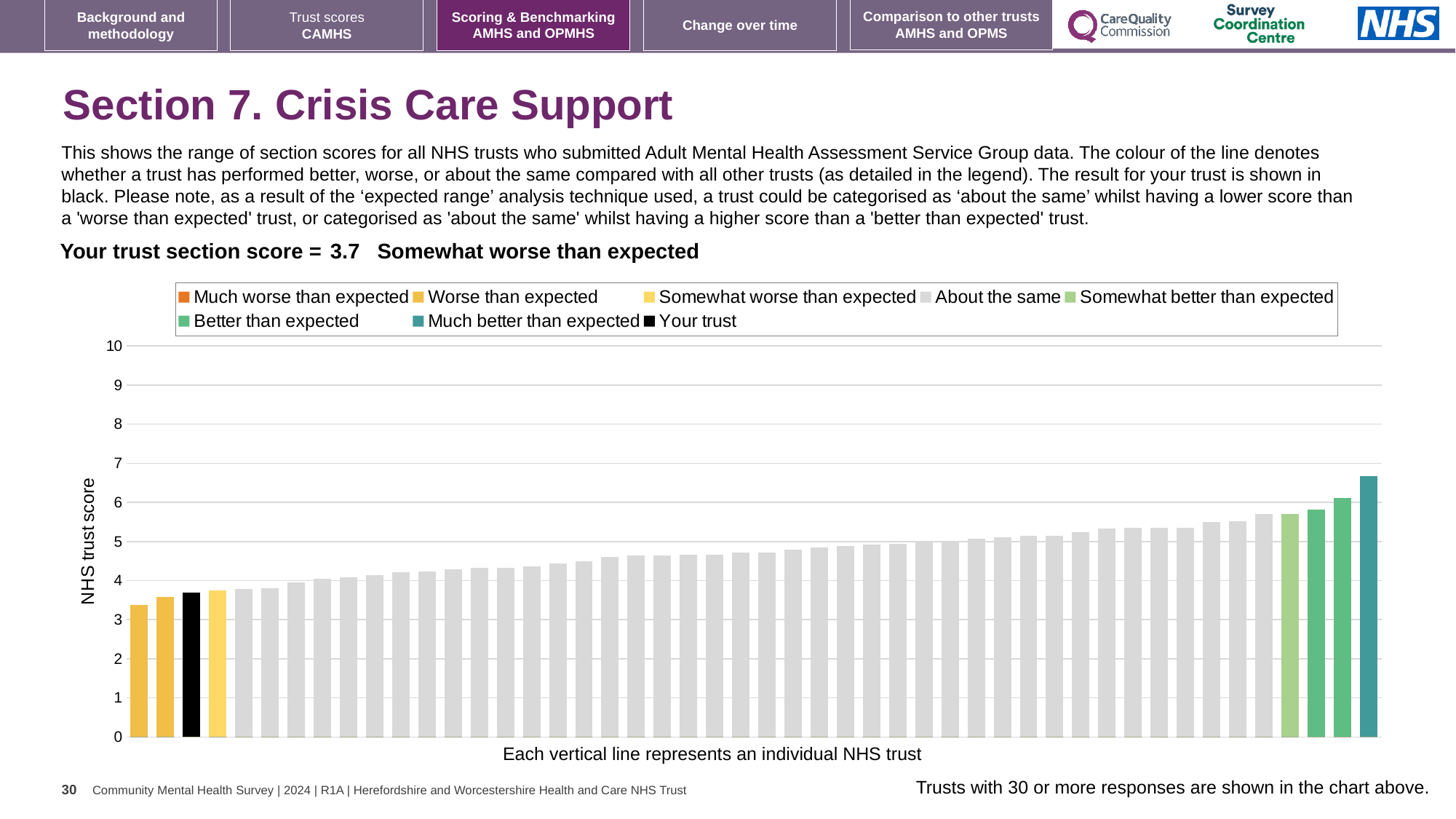
Is the value of the tallest bar greater or less than 6? greater Is the value of the tallest bar greater or less than 7? less Do the bar values rise or fall from left to right along the x axis? rise What kind of chart is shown on the slide? bar chart How many bars are coloured as 'Much better than expected'? 1 Which legend category does the shortest bar belong to? Worse than expected How many entries does the chart legend list? 8 What is the section score for your trust? 3.7 Is the value for your trust greater or less than 4? less What is the label on the vertical axis? NHS trust score Which legend category does the tallest bar belong to? Much better than expected